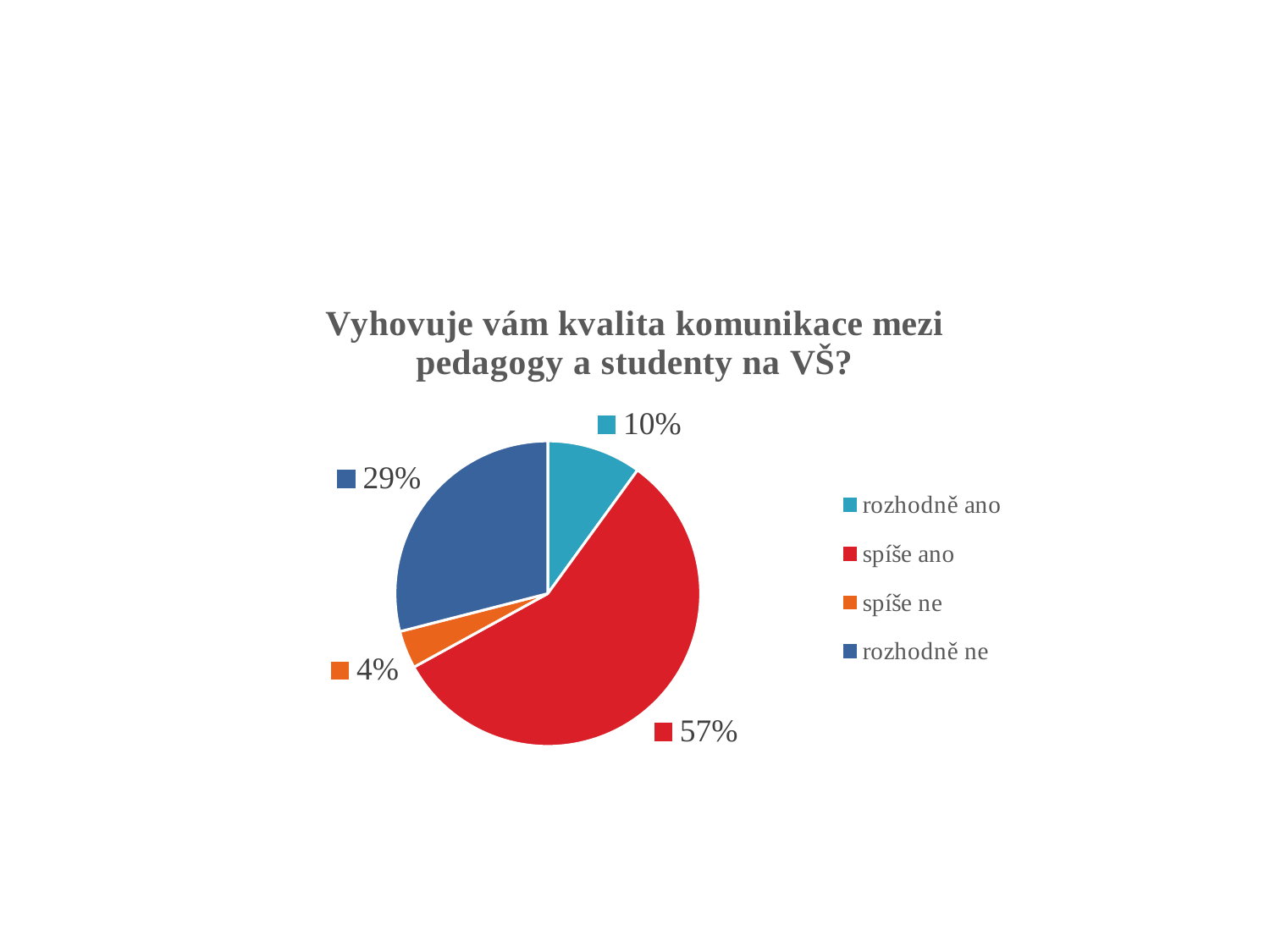
What percentage of respondents answered "rozhodně ano"? 10% Which is larger, the share for "rozhodně ano" or the share for "rozhodně ne"? rozhodně ne Which answer has the largest share of the pie? spíše ano What percentage of respondents answered "spíše ano"? 57% What kind of chart is shown on the slide? pie chart What colour is the slice for "spíše ne"? orange How many categories does the legend list? 4 Which answer has the smallest share of the pie? spíše ne What percentage of respondents answered "rozhodně ne"? 29% What percentage of respondents answered "spíše ne"? 4% What is the title of the chart? Vyhovuje vám kvalita komunikace mezi pedagogy a studenty na VŠ? What is the difference in percentage points between "spíše ano" and "rozhodně ne"? 28